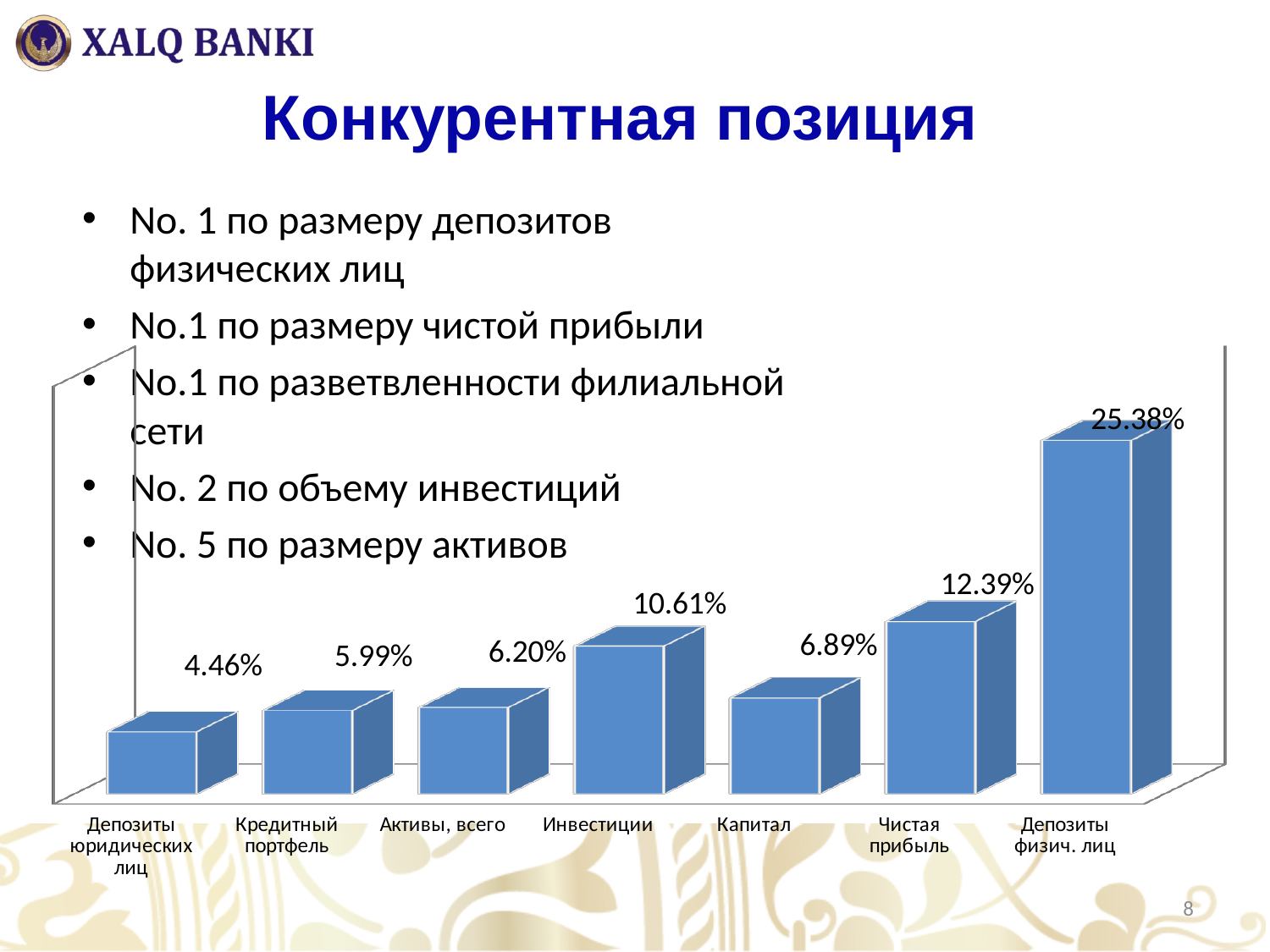
How many categories are shown in the chart? 7 What is the value for Кредитный портфель? 5.99% What kind of chart is shown on the slide? Bar chart Which category has the lowest value? Депозиты юридических лиц What is the difference between the values for Депозиты физич. лиц and Чистая прибыль? 12.99% What is the value for Депозиты физич. лиц? 25.38% What is the value for Капитал? 6.89% Do the values rise or fall from Капитал to Депозиты физич. лиц along the x axis? Rise Which category has the highest value? Депозиты физич. лиц What is the value for Инвестиции? 10.61% Which is larger, the value for Капитал or the value for Активы, всего? Капитал What is the difference between the values for Инвестиции and Активы, всего? 4.41%